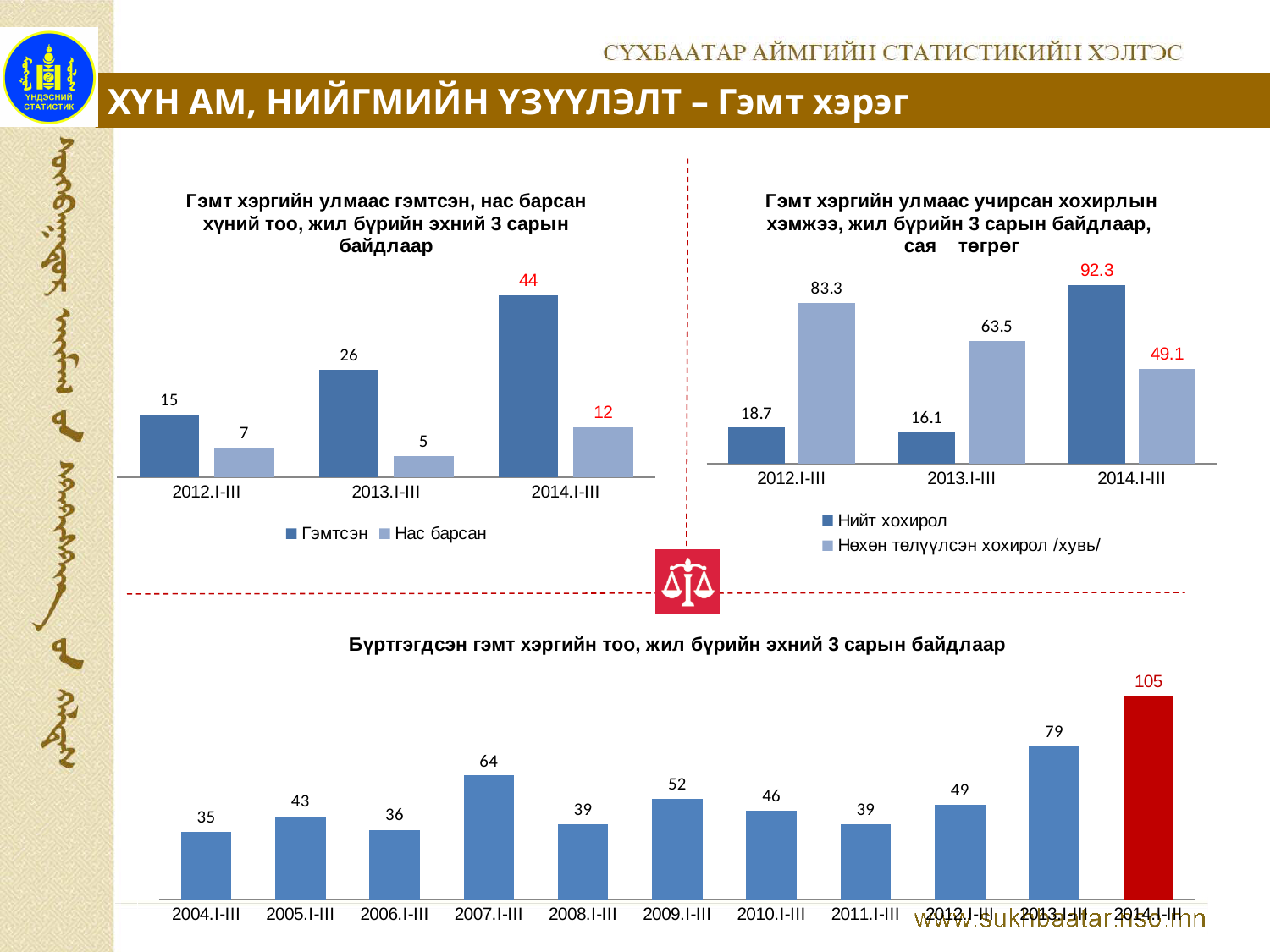
In the bottom chart (Бүртгэгдсэн гэмт хэргийн тоо), how many years are shown on the x axis? 11 In the top-right chart (Гэмт хэргийн улмаас учирсан хохирлын хэмжээ), in which year is Нийт хохирол highest? 2014.I-III In the bottom chart (Бүртгэгдсэн гэмт хэргийн тоо), what is the difference between 2014.I-III and 2013.I-III? 26 In the top-right chart (Гэмт хэргийн улмаас учирсан хохирлын хэмжээ), which is larger: Нөхөн төлүүлсэн хохирол in 2012.I-III or in 2013.I-III? 2012.I-III In the top-right chart (Гэмт хэргийн улмаас учирсан хохирлын хэмжээ), what is the value for Нийт хохирол in 2012.I-III? 18.7 In the top-left chart (Гэмт хэргийн улмаас гэмтсэн, нас барсан хүний тоо), what is the value for Гэмтсэн in 2014.I-III? 44 In the top-right chart (Гэмт хэргийн улмаас учирсан хохирлын хэмжээ), what is the value for Нөхөн төлүүлсэн хохирол /хувь/ in 2014.I-III? 49.1 In the top-left chart (Гэмт хэргийн улмаас гэмтсэн, нас барсан хүний тоо), what is the value for Нас барсан in 2013.I-III? 5 In the bottom chart (Бүртгэгдсэн гэмт хэргийн тоо), which year has the lowest value? 2004.I-III In the top-left chart (Гэмт хэргийн улмаас гэмтсэн, нас барсан хүний тоо), how many series does the legend list? 2 In the top-left chart (Гэмт хэргийн улмаас гэмтсэн, нас барсан хүний тоо), what is the difference between Гэмтсэн and Нас барсан in 2012.I-III? 8 In the bottom chart (Бүртгэгдсэн гэмт хэргийн тоо), what is the value for 2007.I-III? 64